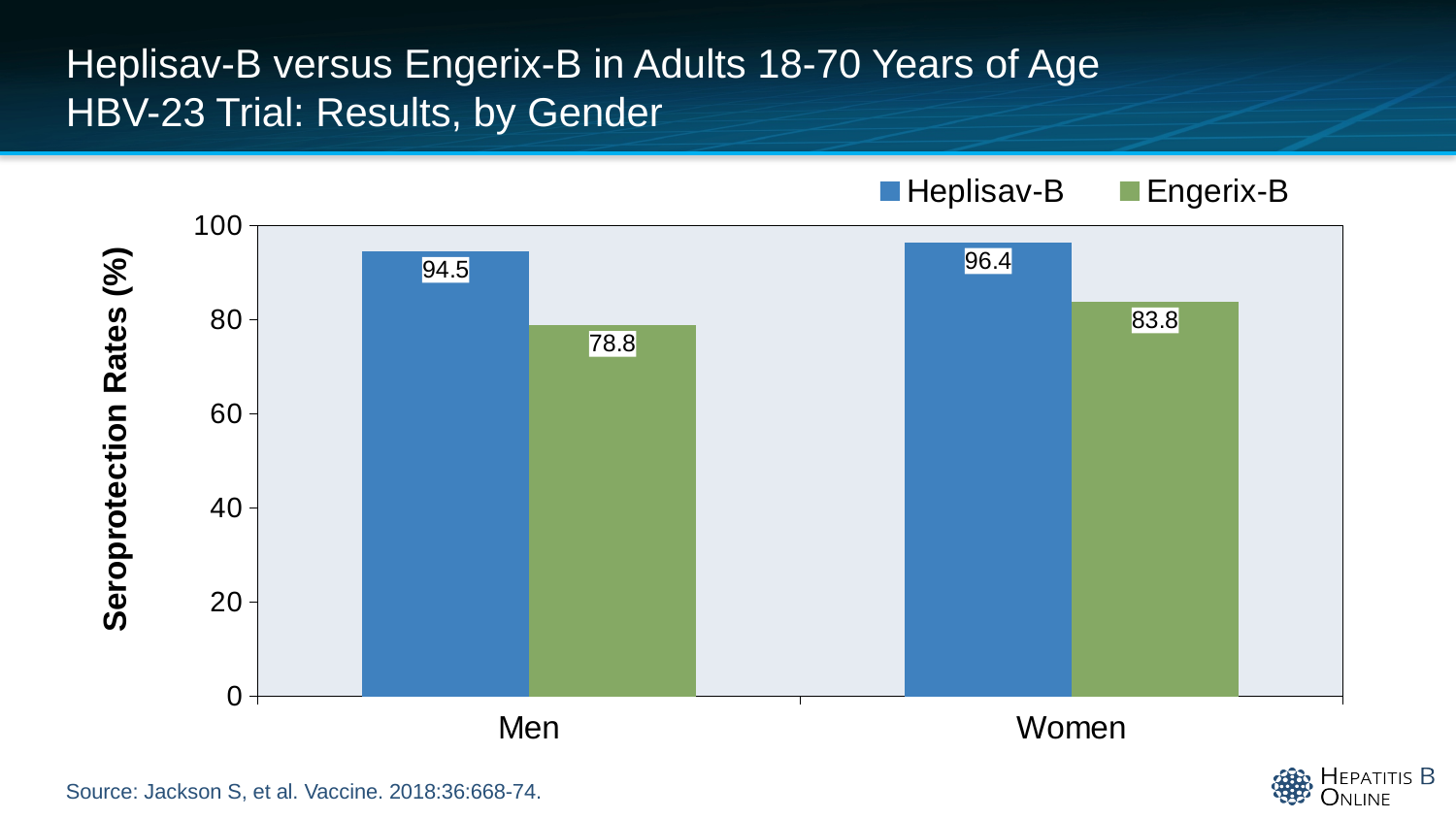
What is the difference between the Heplisav-B and Engerix-B seroprotection rates in women? 12.6 Which bar shows the lowest seroprotection rate on the chart? Engerix-B in men How many categories are shown on the x axis? 2 What is the seroprotection rate for Engerix-B in women? 83.8 Which gender group has the highest Heplisav-B seroprotection rate? Women What kind of chart is shown on the slide? Bar chart Which is larger, the Engerix-B rate in women or the Engerix-B rate in men? Engerix-B rate in women How many series does the legend list? 2 What is the seroprotection rate for Heplisav-B in men? 94.5 What is the difference between the Heplisav-B and Engerix-B seroprotection rates in men? 15.7 Is the Engerix-B seroprotection rate in men greater or less than 80? less What is the seroprotection rate for Engerix-B in men? 78.8